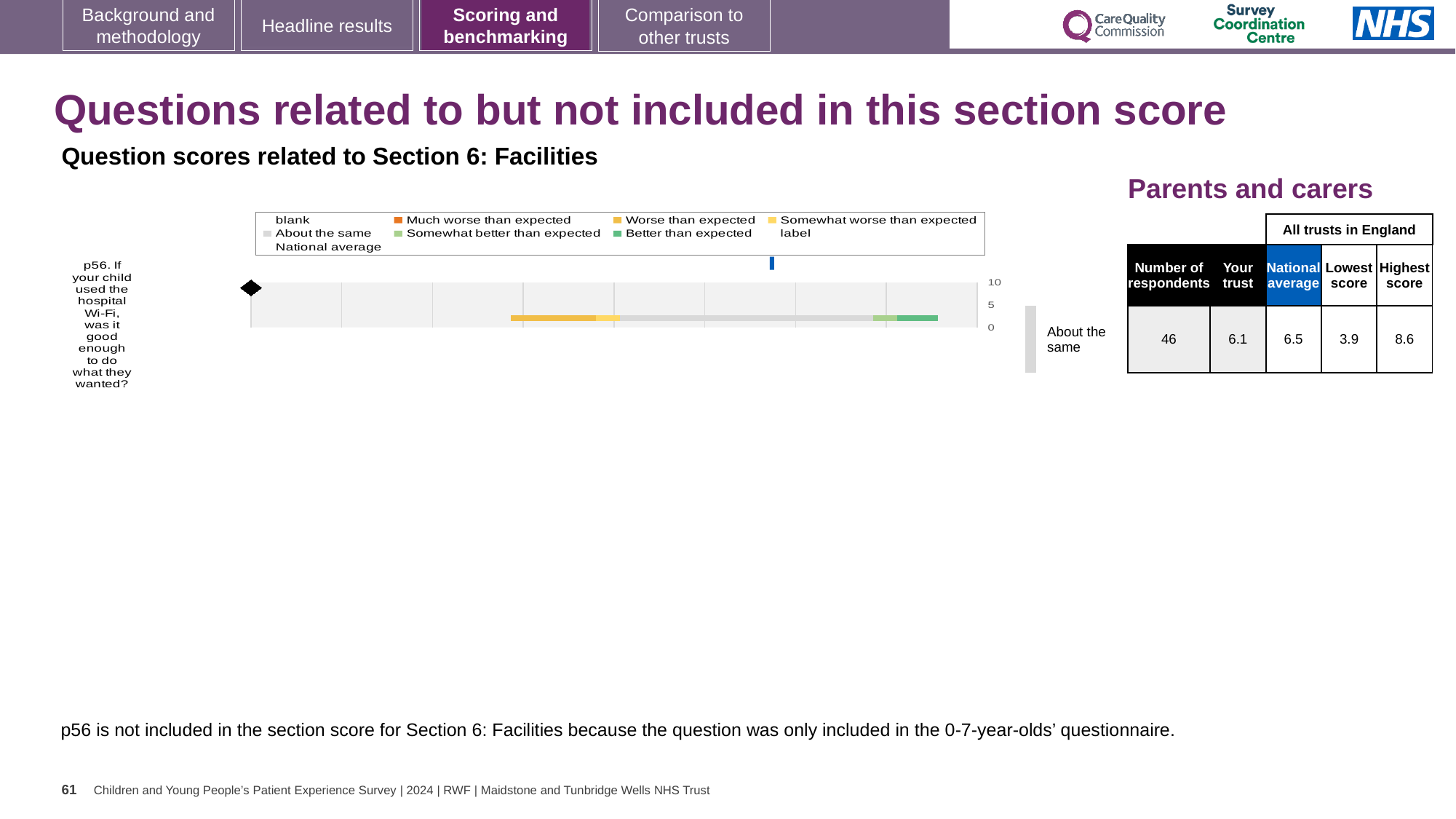
How many questions (categories) are plotted on the chart? 1 What is the 'Your trust' score for p56 shown in the table next to the chart? 6.1 How many entries does the chart legend list? 9 Which question number is plotted on the chart? p56 What is the national average score for p56 shown in the table next to the chart? 6.5 What is the lowest score across all trusts in England for p56? 3.9 What kind of chart is used to show the p56 benchmarking result? bar chart What is the highest score across all trusts in England for p56? 8.6 Which is larger for p56, the 'Your trust' score or the national average? National average How many respondents answered p56 according to the table next to the chart? 46 What is the highest tick value shown on the chart's score axis? 10 What is the difference between the highest score and the lowest score for p56? 4.7